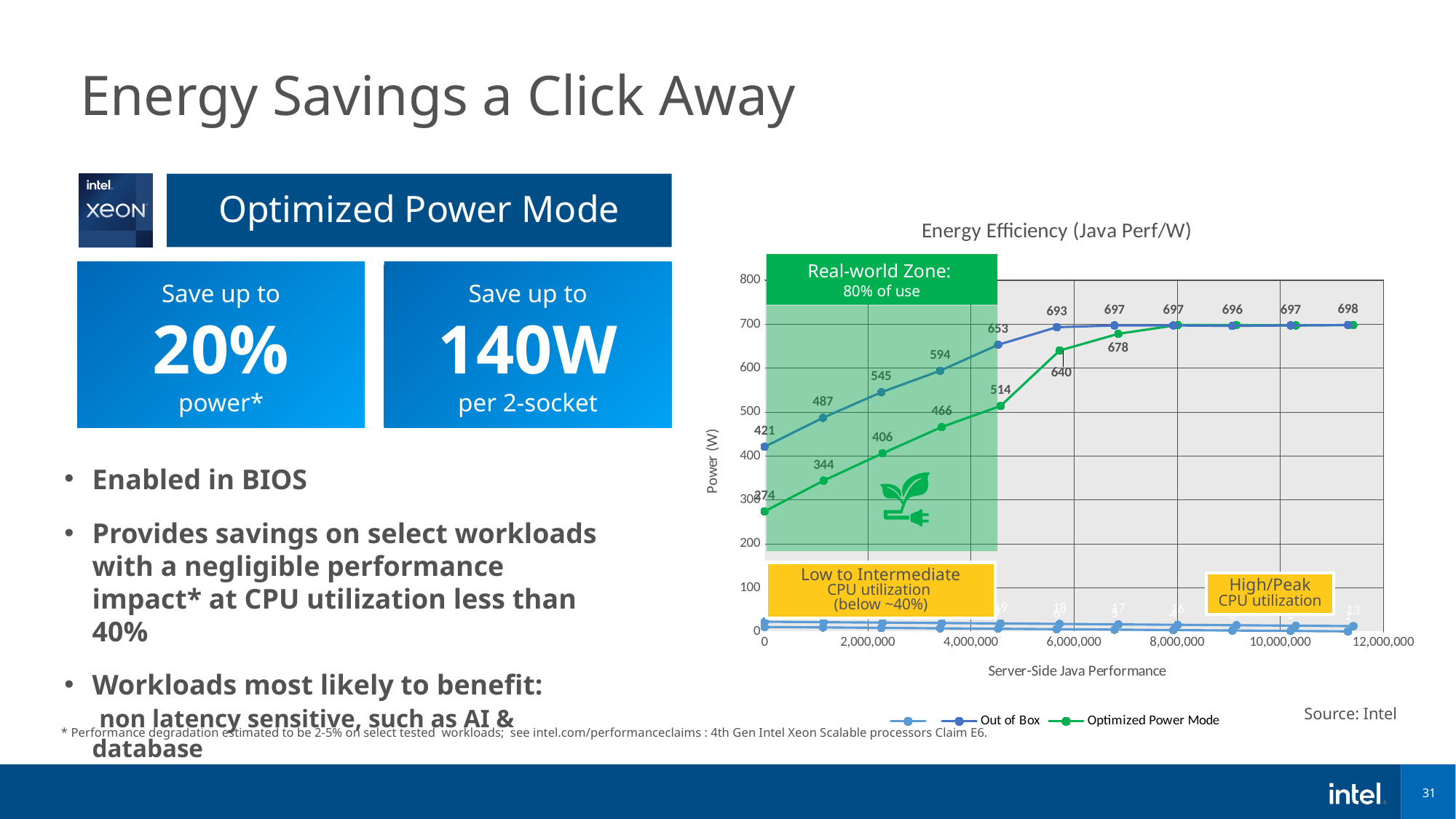
What is the difference between the Out of Box and Optimized Power Mode values at the fifth data point from the left (at the right edge of the Real-world Zone)? 139 At the leftmost data point, which line has the higher value, Out of Box or Optimized Power Mode? Out of Box What is the first (leftmost) labelled value on the Out of Box line? 421 What is the first (leftmost) labelled value on the Optimized Power Mode line? 274 What is the highest labelled value on the Out of Box line? 698 What is the difference between the leftmost Out of Box value and the leftmost Optimized Power Mode value? 147 Does the Out of Box line rise or fall as Server-Side Java Performance increases? rise How many data points are plotted on the Out of Box line? 11 What is the title of the y axis of the chart? Power (W) What is the lowest labelled value on the Optimized Power Mode line? 274 What kind of chart is the Energy Efficiency (Java Perf/W) chart? line chart What is the fourth labelled value from the left on the Optimized Power Mode line? 466